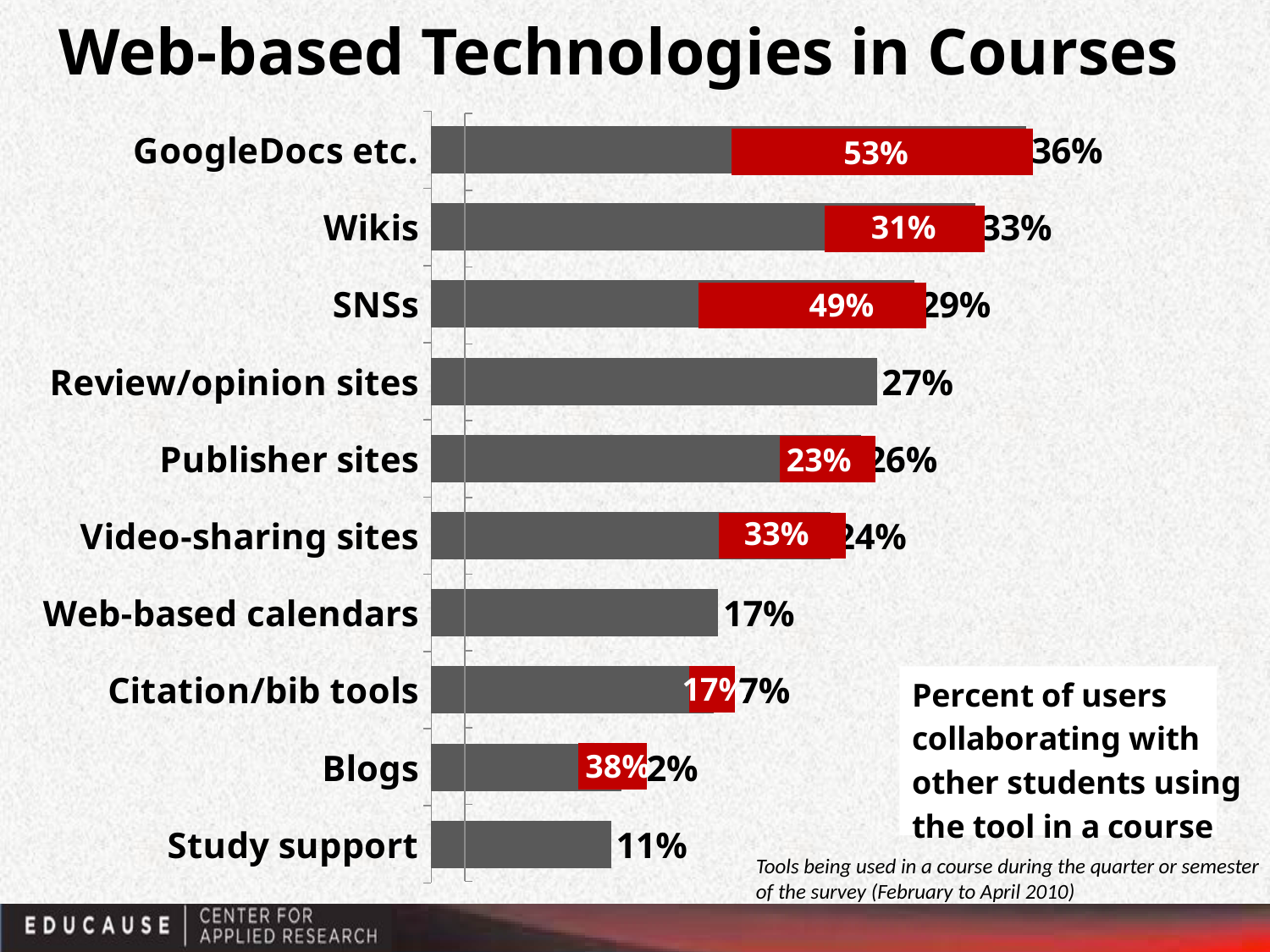
What percent of SNSs users collaborate with other students using the tool in a course? 49% Which has a higher percent of users collaborating with other students: Wikis or Video-sharing sites? Video-sharing sites What percent of GoogleDocs etc. users collaborate with other students using the tool in a course? 53% What is the difference between the percent of students using Wikis in a course and the percent using Web-based calendars? 16% What percent of students use Study support tools in a course? 11% Which technology has the highest percent of students using it in a course? GoogleDocs etc. What percent of students use Review/opinion sites in a course? 27% What kind of chart is shown on the slide? bar chart What percent of Blogs users collaborate with other students using the tool in a course? 38% Which technology has the lowest percent of students using it in a course? Study support How many technology categories are listed on the chart? 10 What percent of students use GoogleDocs etc. in a course? 36%